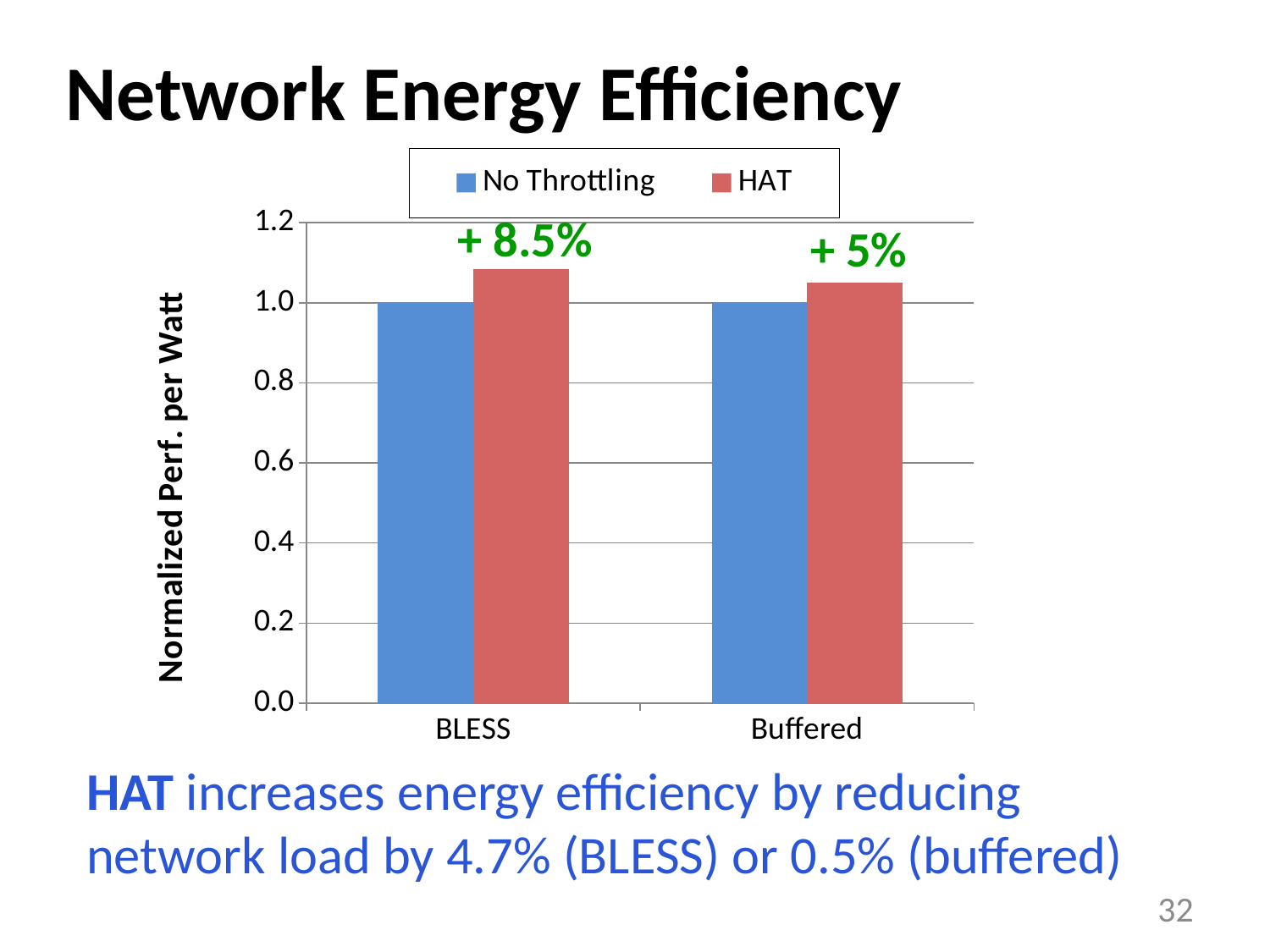
How many categories are shown on the x axis? 2 Which category has the higher HAT value, BLESS or Buffered? BLESS Is the value for HAT in the Buffered category greater or less than 1.2? less What percentage improvement is annotated above the HAT bar for BLESS? + 8.5% What is the value for No Throttling in the Buffered category? 1.0 How many series does the legend list? 2 Which is larger in the BLESS category, No Throttling or HAT? HAT What is the label of the y axis? Normalized Perf. per Watt Is the value for HAT in the BLESS category greater or less than 1.0? greater What is the value for No Throttling in the BLESS category? 1.0 Which bar is the highest in the chart? HAT for BLESS What kind of chart is shown on the slide? bar chart